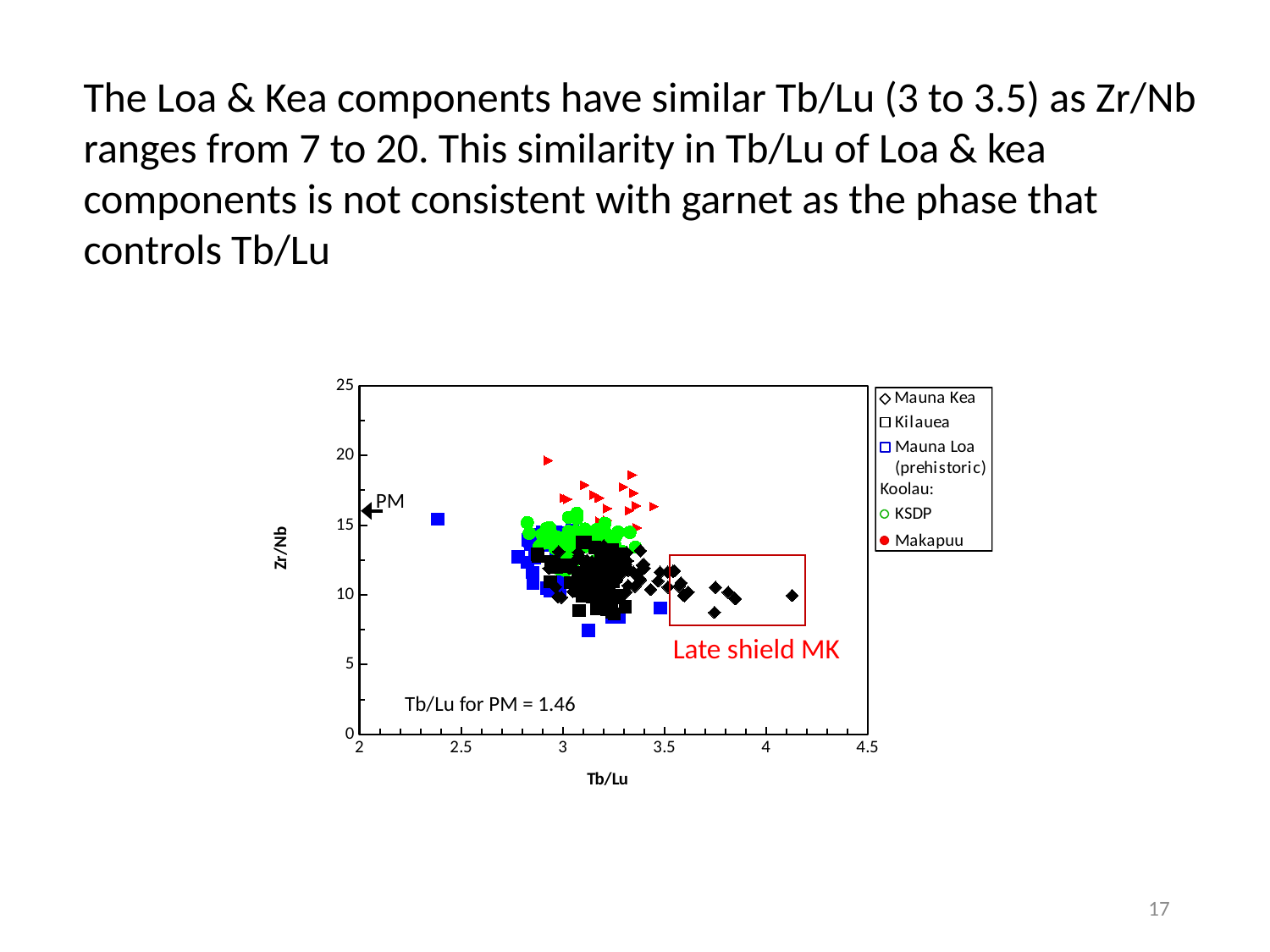
What kind of chart is shown on the slide? scatter chart Which series has the lowest Zr/Nb point on the chart? Mauna Loa (prehistoric) Which series has the highest Zr/Nb values on the chart? Makapuu Are the Zr/Nb values of the points inside the 'Late shield MK' box greater or less than 15? less Which series extends to the highest Tb/Lu values on the chart? Mauna Kea What is the label of the y axis of the chart? Zr/Nb How many series does the chart's legend list with markers? 5 According to the annotation on the chart, what is the Tb/Lu value for PM? 1.46 Is the Tb/Lu value of the point labelled PM greater or less than 2.5? less What is the label of the x axis of the chart? Tb/Lu What is the maximum value shown on the x axis of the chart? 4.5